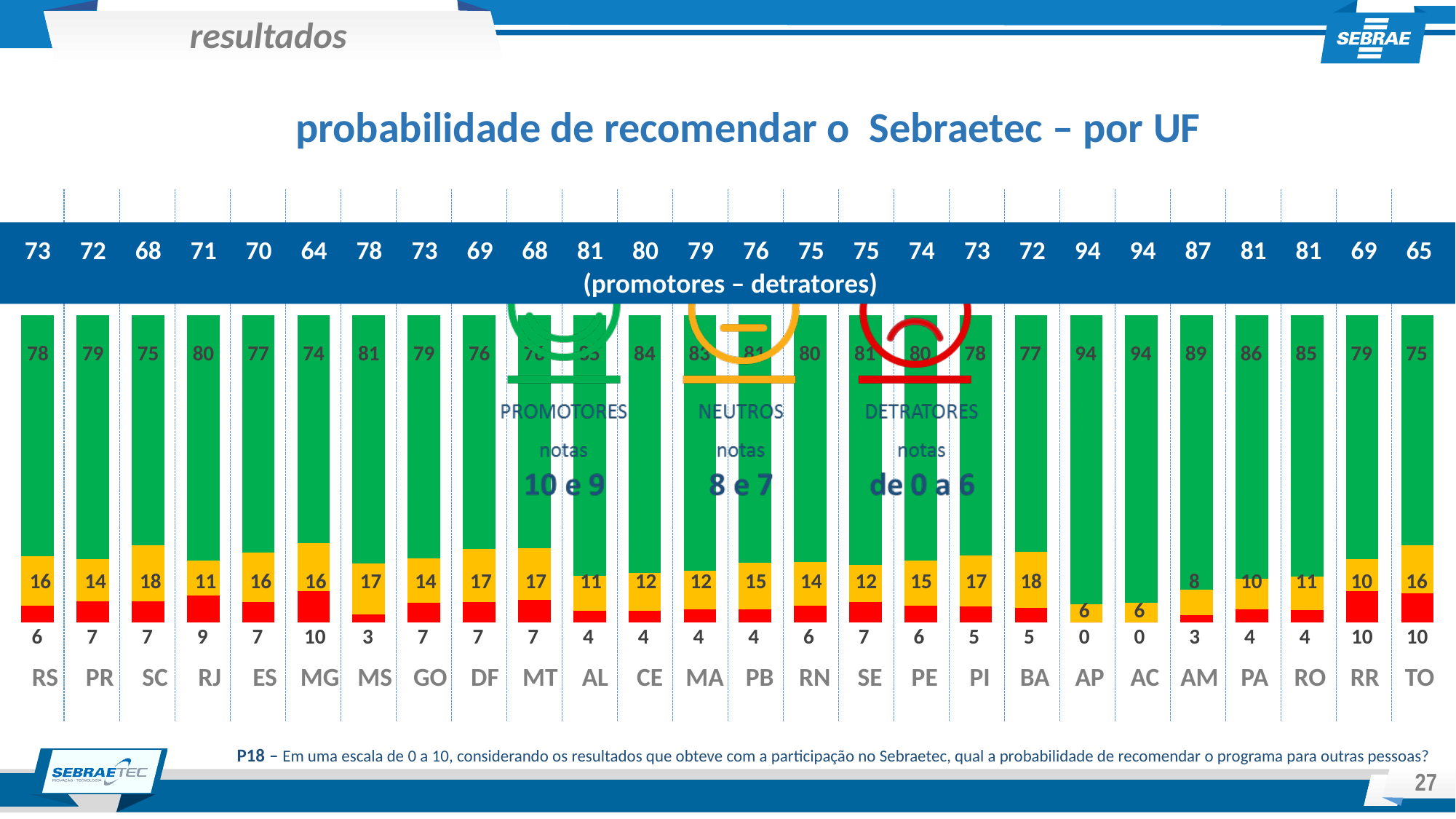
What is the detratores (red) value for RJ? 9 What is the total of the stacked bar for PA (promotores + neutros + detratores)? 100 Which has a larger detratores value, MG or MS? MG What is the promotores (green) value for MS? 81 Which UF has the lowest promotores – detratores value? MG According to the chart annotation, which scores define the PROMOTORES group? 10 e 9 Which UF has the lowest promotores (green) value? MG What is the difference between the promotores values of CE and TO? 9 What kind of chart is shown on the slide? Stacked bar chart What is the promotores – detratores value shown for AM? 87 What is the neutros (yellow) value for BA? 18 How many UFs are shown in the chart? 26